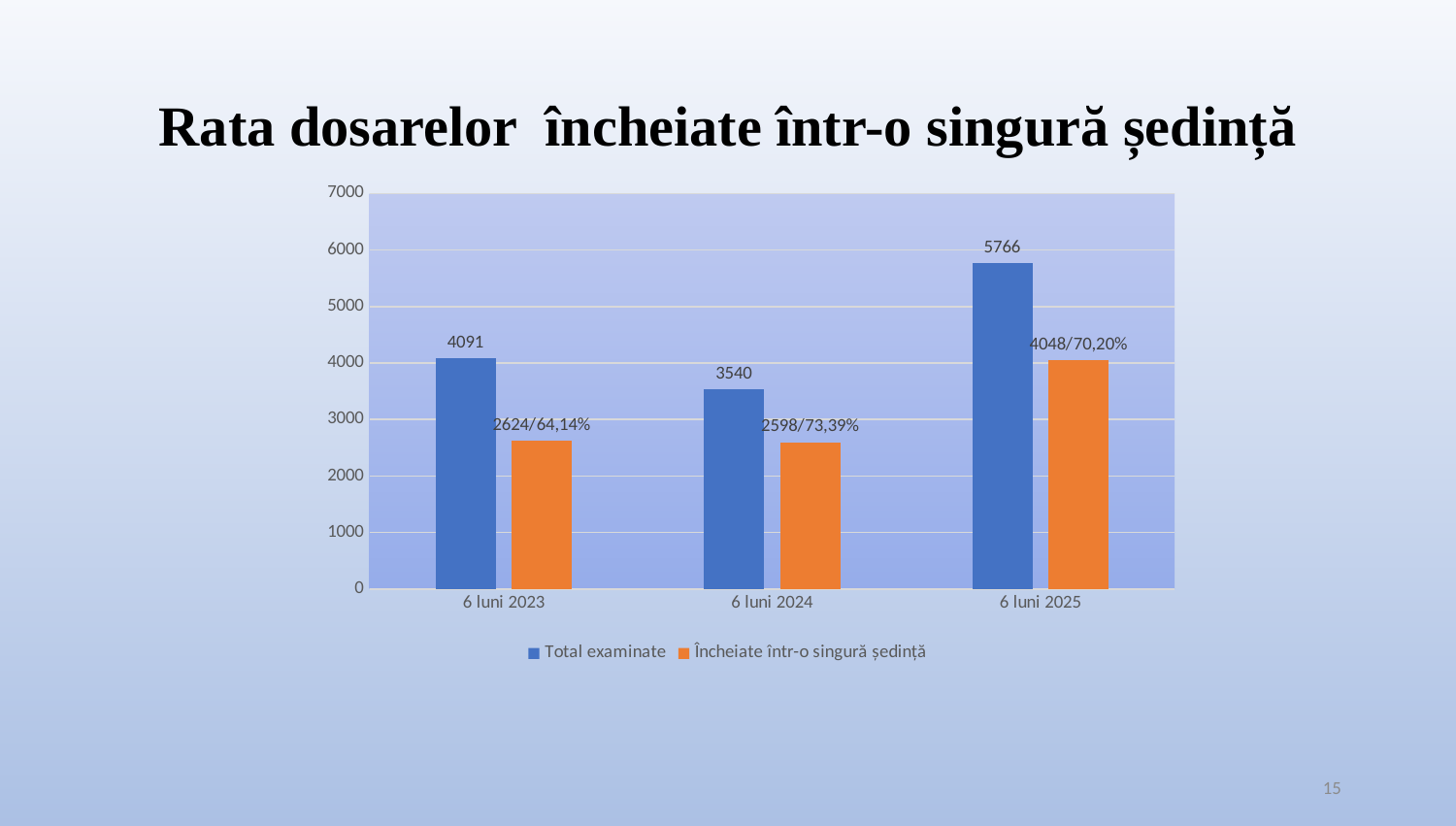
What is the difference between Total examinate for 6 luni 2025 and 6 luni 2023? 1675 Which period has the lowest Total examinate value? 6 luni 2024 What is the data label on the Încheiate într-o singură ședință bar for 6 luni 2025? 4048/70,20% How many series does the legend list? 2 What is the value of Total examinate for 6 luni 2025? 5766 What is the value of Total examinate for 6 luni 2024? 3540 What kind of chart is shown on the slide? bar chart Is the Total examinate value for 6 luni 2024 greater or less than 4000? less How many periods are shown on the x axis? 3 What is the data label on the Încheiate într-o singură ședință bar for 6 luni 2023? 2624/64,14% Which is larger: Total examinate for 6 luni 2023 or for 6 luni 2024? 6 luni 2023 Which period has the highest Total examinate value? 6 luni 2025